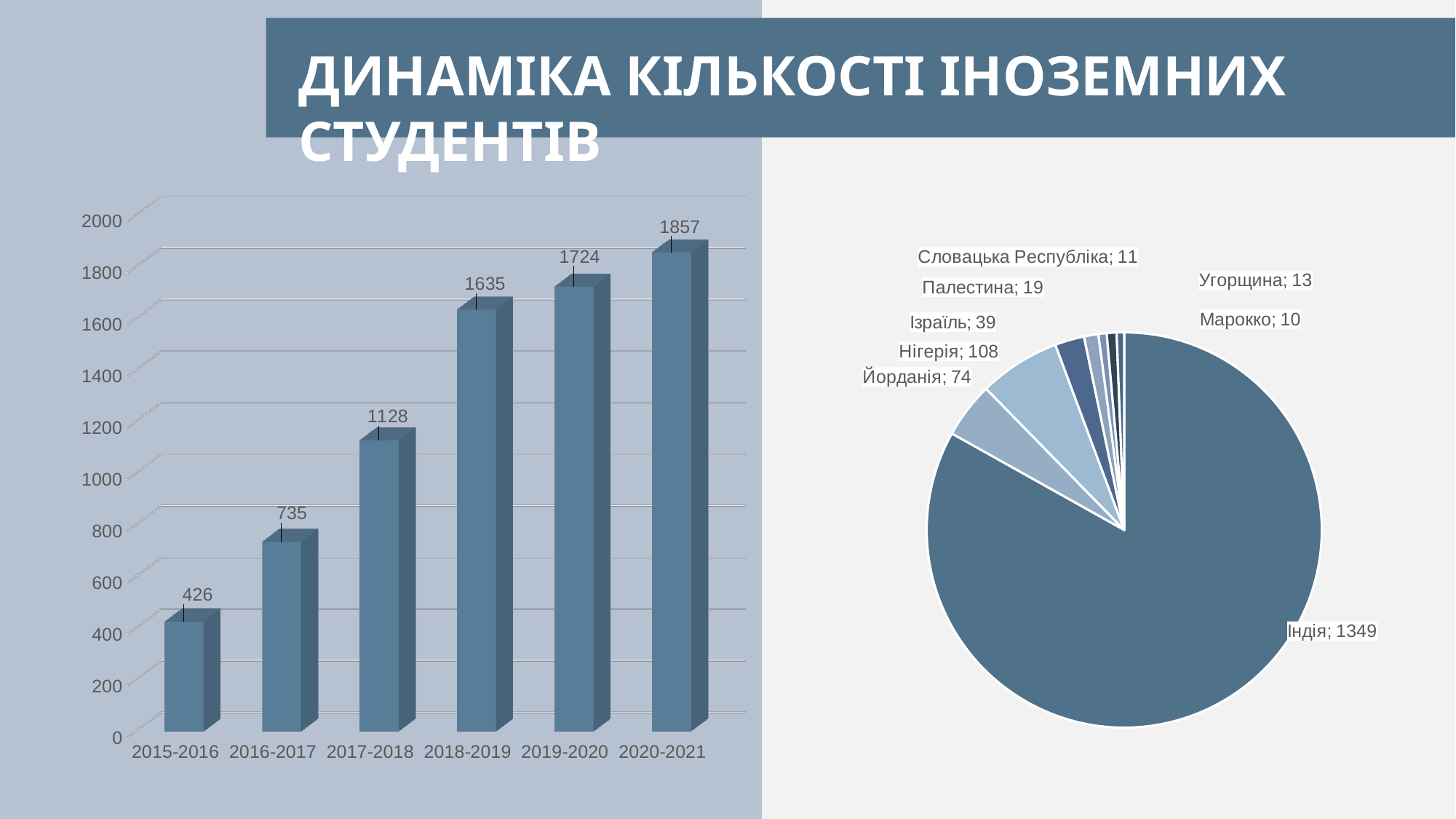
On the pie chart on the right, what is the value for Нігерія? 108 On the bar chart on the left, what is the value for 2017-2018? 1128 On the bar chart on the left, which year has the lowest value? 2015-2016 On the pie chart on the right, which country has the largest slice? Індія On the bar chart on the left, which year has the highest value? 2020-2021 What kind of chart is shown on the left of the slide? bar chart On the pie chart on the right, what is the difference between the values for Палестина and Угорщина? 6 On the bar chart on the left, do the values rise or fall from 2015-2016 to 2020-2021? rise On the bar chart on the left, what is the value for 2020-2021? 1857 On the bar chart on the left, how many academic years are shown? 6 On the pie chart on the right, which is larger, Йорданія or Ізраїль? Йорданія On the bar chart on the left, what is the difference between the values for 2016-2017 and 2015-2016? 309